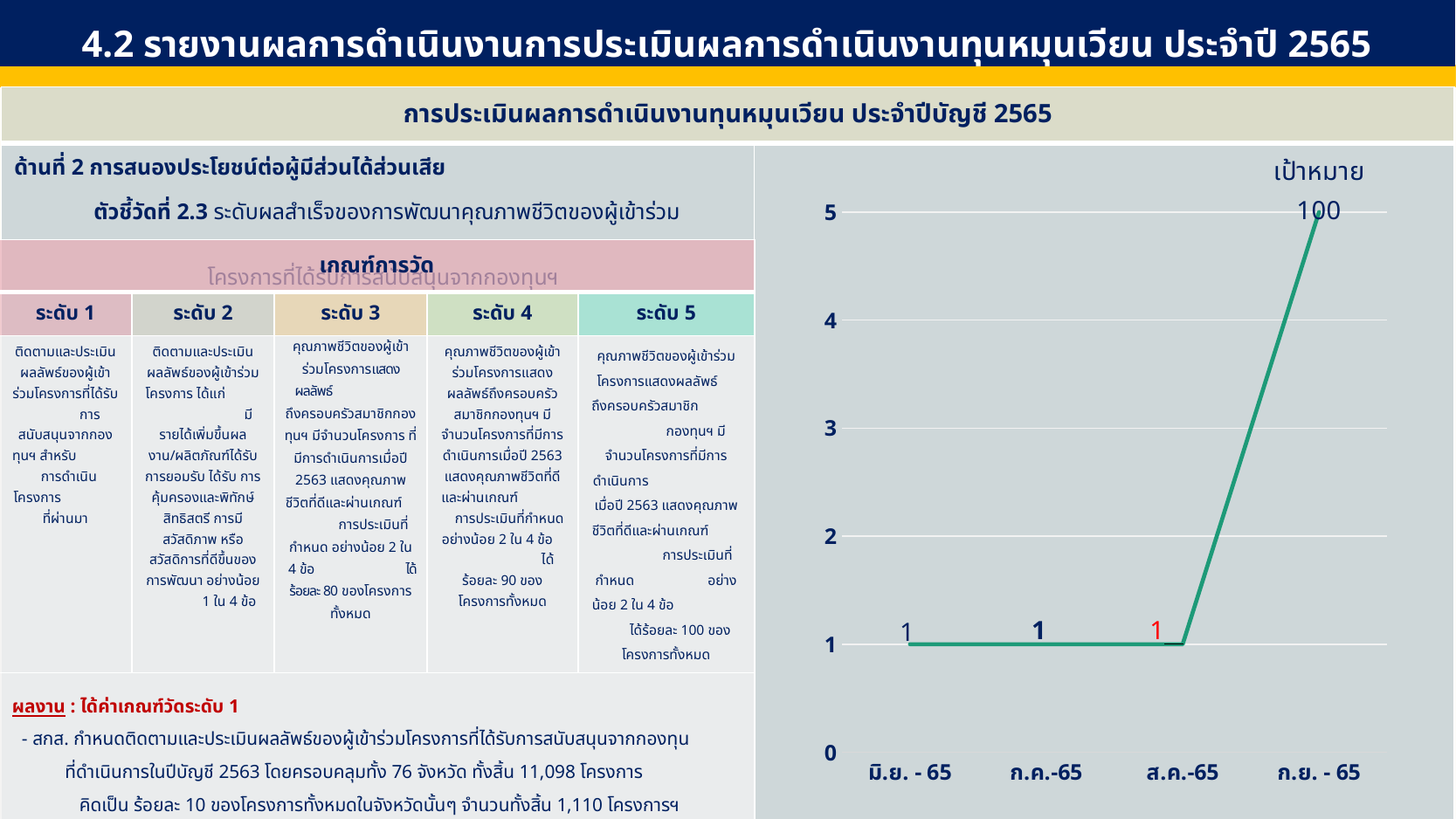
What is the difference between the values for มิ.ย. - 65 and ก.ค.-65 in the line chart? 0 Is the value for ส.ค.-65 greater or less than 2? less What is the highest tick value shown on the y axis of the line chart? 5 What is the value for ก.ค.-65 in the line chart? 1 Which x-axis category has the highest value in the line chart? ก.ย. - 65 What kind of chart is shown on the right side of the slide? line chart Which is larger in the line chart, the value for ก.ย. - 65 or the value for ส.ค.-65? ก.ย. - 65 What is the value for ส.ค.-65 in the line chart? 1 What is the value for มิ.ย. - 65 in the line chart? 1 How many points are plotted along the x axis of the line chart? 4 Do the values in the line chart rise or fall between ส.ค.-65 and ก.ย. - 65? rise Is the value for ก.ย. - 65 greater or less than 4? greater